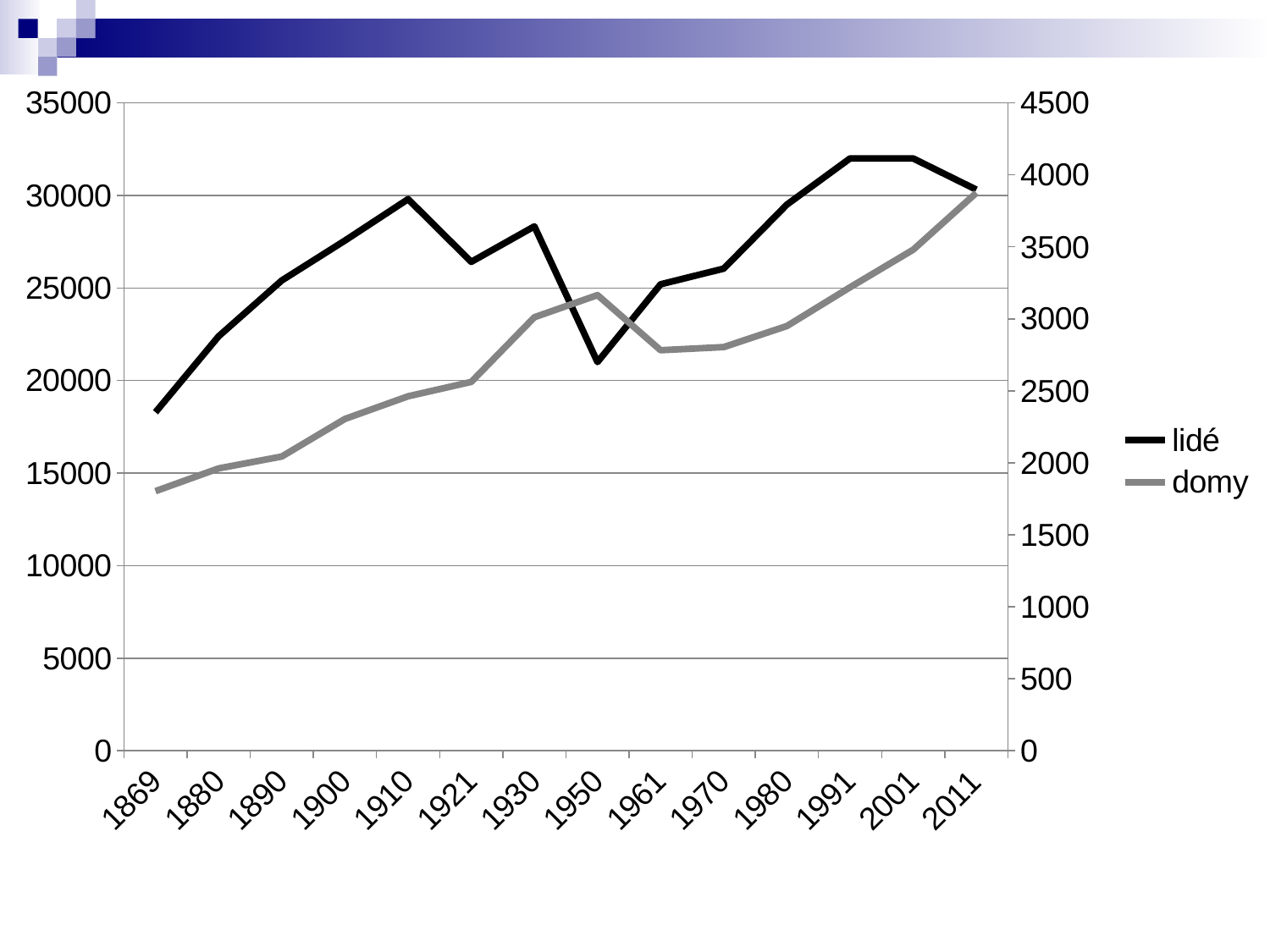
Is the value for lidé in 1991 greater or less than 30000? greater Which year has the lowest value for the lidé series? 1869 Which is larger for the lidé series, the value in 1910 or the value in 1950? 1910 How many series does the legend list? 2 Does the domy series rise or fall between 1869 and 1930? rise Is the value for lidé in 1869 greater or less than 20000? less How many years are plotted along the x axis? 14 What colour is the line for the lidé series? black Which year has the highest value for the domy series? 2011 Is the value for domy in 1900 greater or less than 2500? less What kind of chart is shown on the slide? line chart